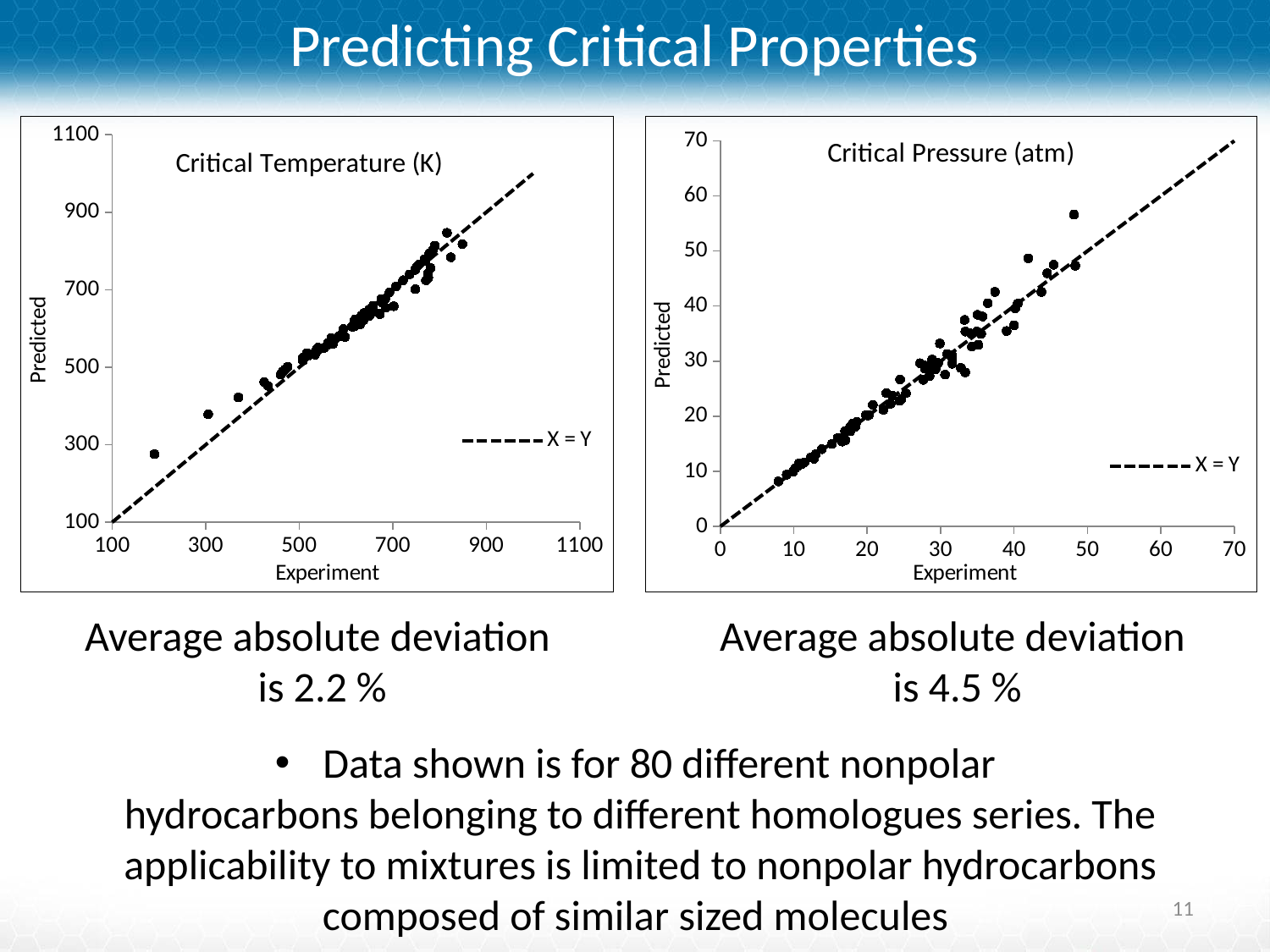
In the Critical Temperature (K) chart, is the predicted value of the lowest data point (at an experimental value near 200) greater or less than 300? less In the Critical Temperature (K) chart, do the predicted values rise or fall as the experimental values increase along the x axis? rise In the Critical Pressure (atm) chart, what entry does the legend show for the dashed line? X = Y In the Critical Pressure (atm) chart, is the predicted value of the lowest data point greater or less than 10? less In the Critical Pressure (atm) chart, is the predicted value of the highest data point greater or less than 60? less What kind of chart is the Critical Pressure (atm) chart on the right? scatter chart In the Critical Temperature (K) chart, what is the label of the x axis? Experiment What kind of chart is the Critical Temperature (K) chart on the left? scatter chart In the Critical Pressure (atm) chart, do the predicted values rise or fall as the experimental values increase along the x axis? rise